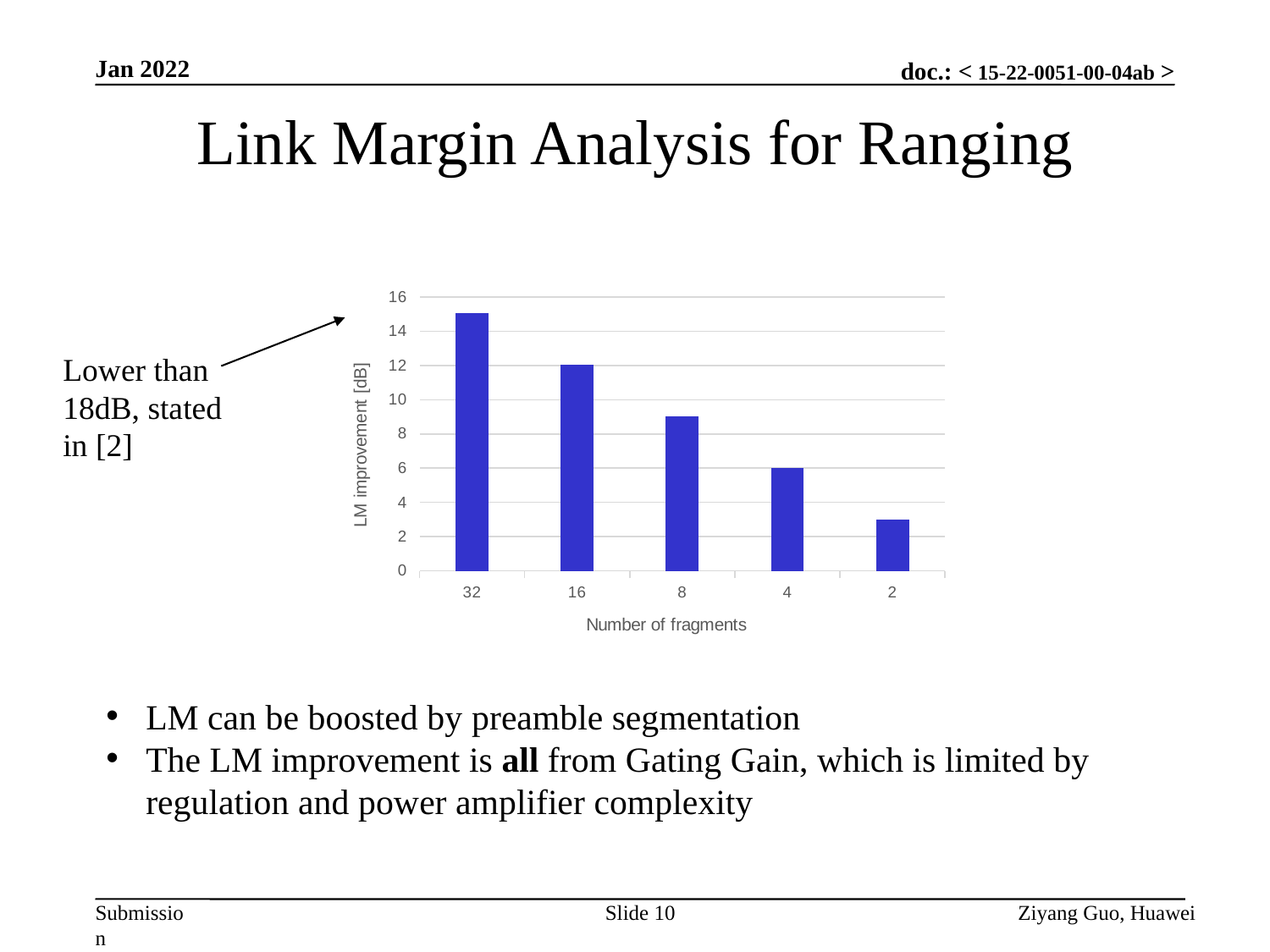
Is the LM improvement for 8 fragments greater or less than 10? less Which number of fragments has the highest LM improvement? 32 How many categories (numbers of fragments) are plotted on the x axis? 5 What kind of chart is shown on the slide? bar chart Is the LM improvement for 2 fragments greater or less than 4? less Which number of fragments has the lowest LM improvement? 2 What is the label of the y axis? LM improvement [dB] Do the bar values rise or fall moving left to right along the x axis? fall Is the LM improvement for 32 fragments greater or less than 14? greater